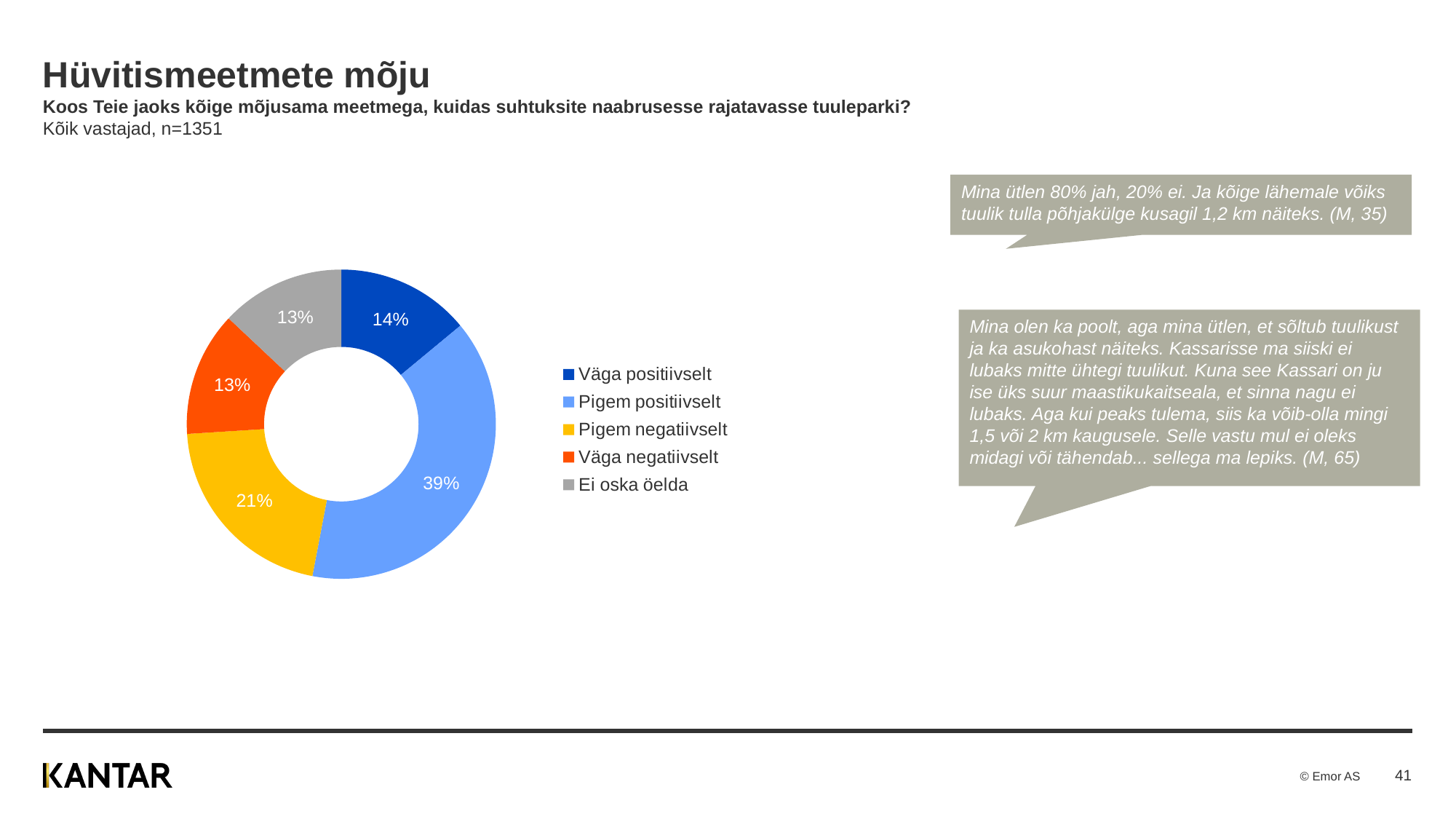
Which is larger, the share for "Väga positiivselt" or for "Pigem negatiivselt"? Pigem negatiivselt How many categories does the chart show? 5 What is the combined share of "Väga positiivselt" and "Pigem positiivselt"? 53% Which colour represents "Ei oska öelda" in the chart? Grey What kind of chart is shown on the slide? Pie chart (donut) Which response category has the largest share? Pigem positiivselt What share of respondents answered "Pigem positiivselt"? 39% What share of respondents answered "Pigem negatiivselt"? 21% What is the difference in percentage points between "Pigem positiivselt" and "Pigem negatiivselt"? 18 percentage points What share of respondents answered "Väga positiivselt"? 14% What share of respondents answered "Ei oska öelda"? 13% What share of respondents answered "Väga negatiivselt"? 13%